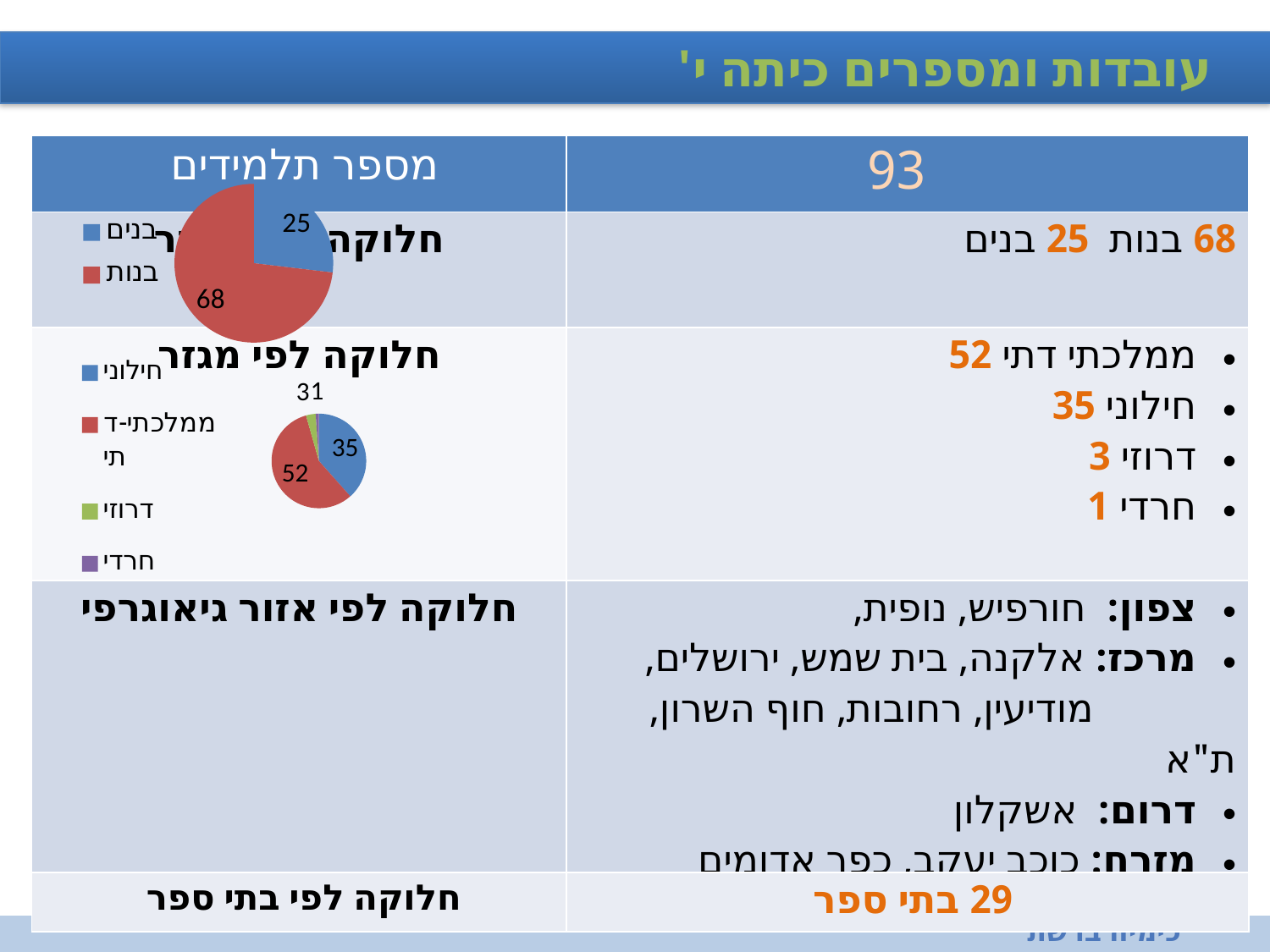
In the upper pie chart (בנים / בנות), what is the total of the two slices? 93 In the upper pie chart (בנים / בנות), what is the value for בנות? 68 What kind of chart is the upper chart on the slide (the one with the legend בנים / בנות)? pie chart In the lower pie chart titled חלוקה לפי מגזר, how many entries does the legend list? 4 In the upper pie chart (בנים / בנות), what is the difference between the value for בנות and the value for בנים? 43 In the upper pie chart (בנים / בנות), which category has the larger slice? בנות In the upper pie chart (בנים / בנות), what is the value for בנים? 25 In the lower pie chart titled חלוקה לפי מגזר, which category has the largest slice? ממלכתי-דתי In the lower pie chart titled חלוקה לפי מגזר, which is larger: the value for ממלכתי-דתי or the value for חילוני? ממלכתי-דתי In the lower pie chart titled חלוקה לפי מגזר, what is the value for חילוני? 35 In the upper pie chart (בנים / בנות), how many slices does the pie have? 2 In the lower pie chart titled חלוקה לפי מגזר, what is the value for ממלכתי-דתי? 52